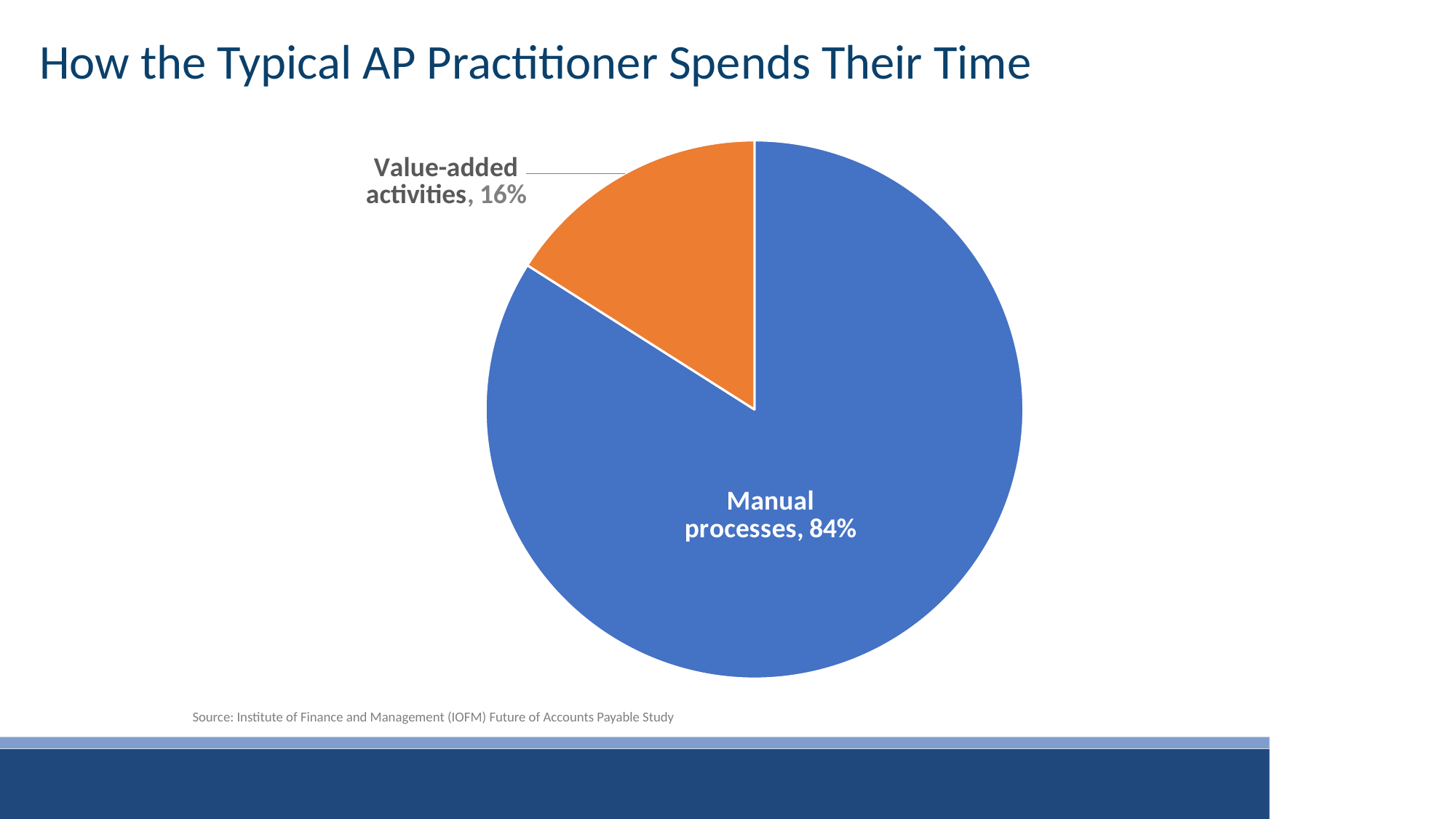
Which slice of the pie is the smallest? Value-added activities What colour is the slice for value-added activities? Orange What is the title of the slide? How the Typical AP Practitioner Spends Their Time Which is larger: the share for manual processes or the share for value-added activities? Manual processes What is the combined share of the two slices in the pie chart? 100% What kind of chart is shown on the slide? Pie chart What is the difference in percentage points between manual processes and value-added activities? 68 Which slice of the pie is the largest? Manual processes How many slices does the pie chart have? 2 What share of time does the typical AP practitioner spend on manual processes? 84% What share of time does the typical AP practitioner spend on value-added activities? 16%